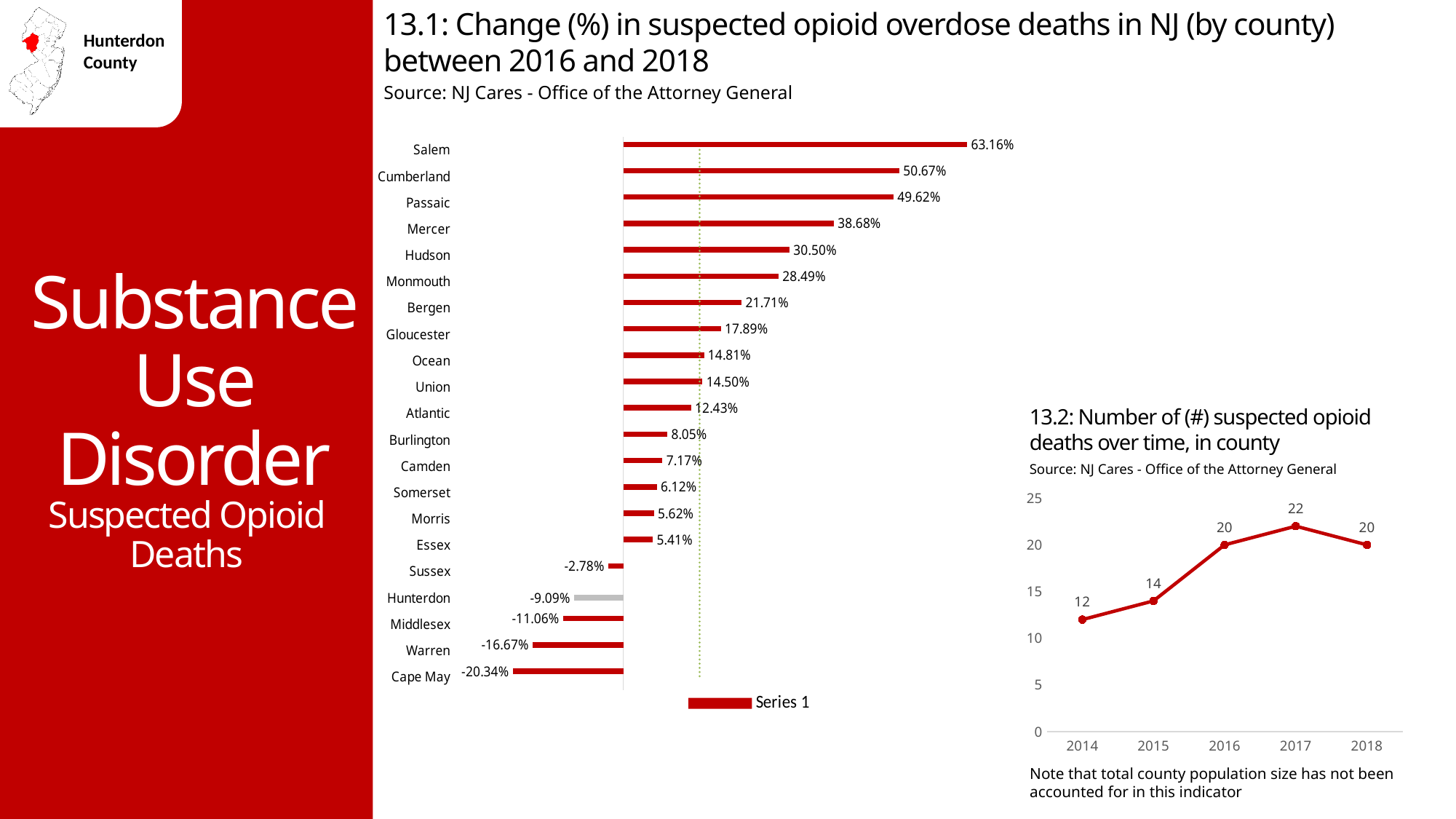
In chart 13.1, what is the value for Mercer? 38.68% In chart 13.1, which has a larger value, Bergen or Gloucester? Bergen In chart 13.2, how many suspected opioid deaths were there in 2017? 22 In chart 13.1, what is the change (%) in suspected opioid overdose deaths for Hunterdon? -9.09% What kind of chart is chart 13.2? Line chart What kind of chart is chart 13.1? Bar chart In chart 13.1, how many counties are shown? 21 In chart 13.1, which county has the lowest change (%) in suspected opioid overdose deaths? Cape May In chart 13.1, what is the difference between the values for Salem and Cumberland? 12.49% In chart 13.2, which year has the lowest number of suspected opioid deaths? 2014 In chart 13.2, what is the difference in suspected opioid deaths between 2016 and 2014? 8 In chart 13.1, which county has the highest change (%) in suspected opioid overdose deaths? Salem